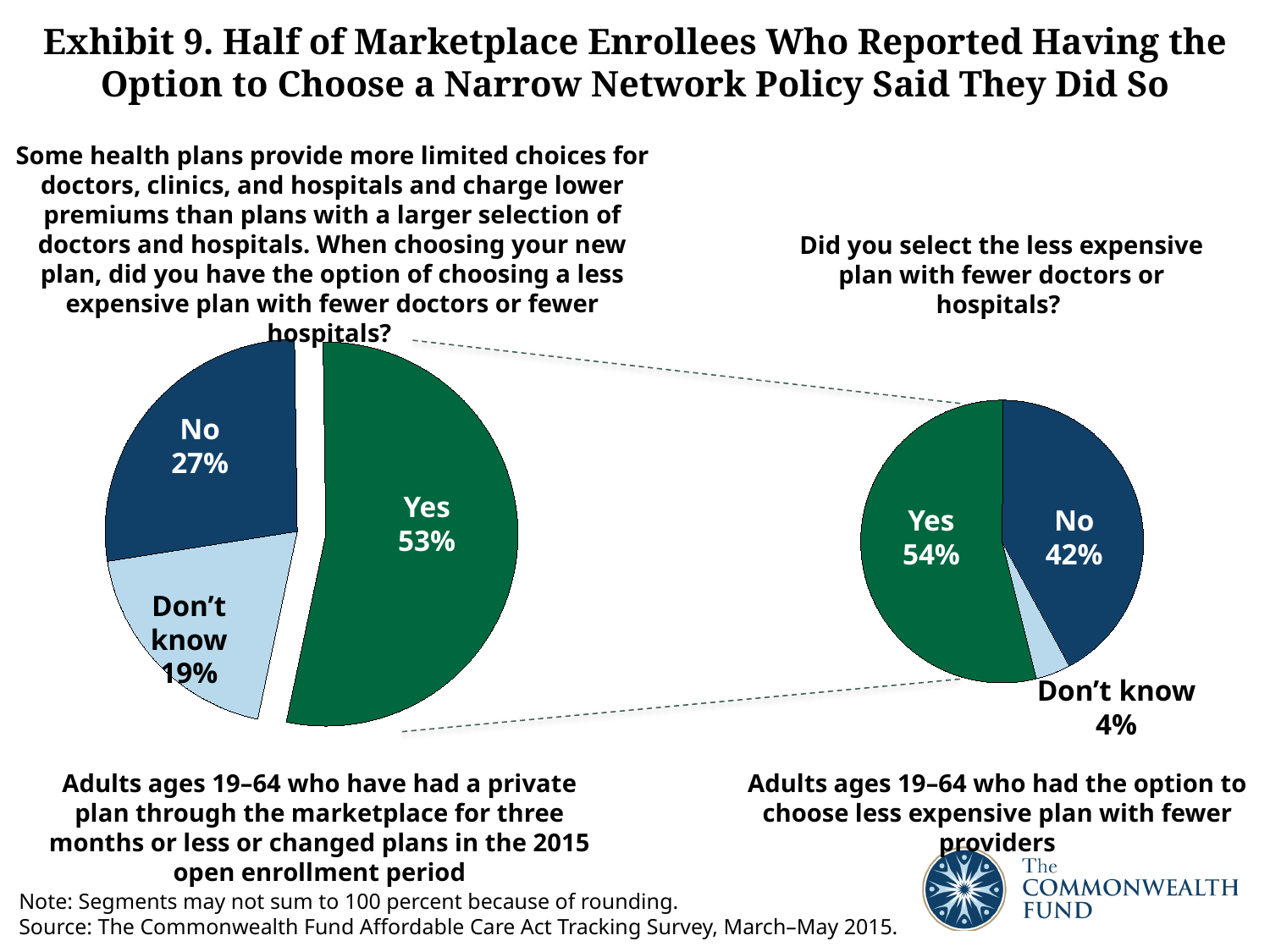
How many slices does the right pie chart have? 3 In the right pie chart, what share answered No? 42% In the right pie chart, what share answered Don't know? 4% In the right pie chart, what is the difference between the Yes and No shares? 12 percentage points What type of chart is used on this slide? Pie chart In the left pie chart, what share answered No? 27% In the right pie chart (did you select the less expensive plan), what share answered Yes? 54% In the left pie chart, which is larger: the No share or the Don't know share? No In the right pie chart, which response has the smallest share? Don't know In the left pie chart, which response has the largest share? Yes In the left pie chart (option of choosing a less expensive plan), what share answered Yes? 53% In the left pie chart, what share answered Don't know? 19%